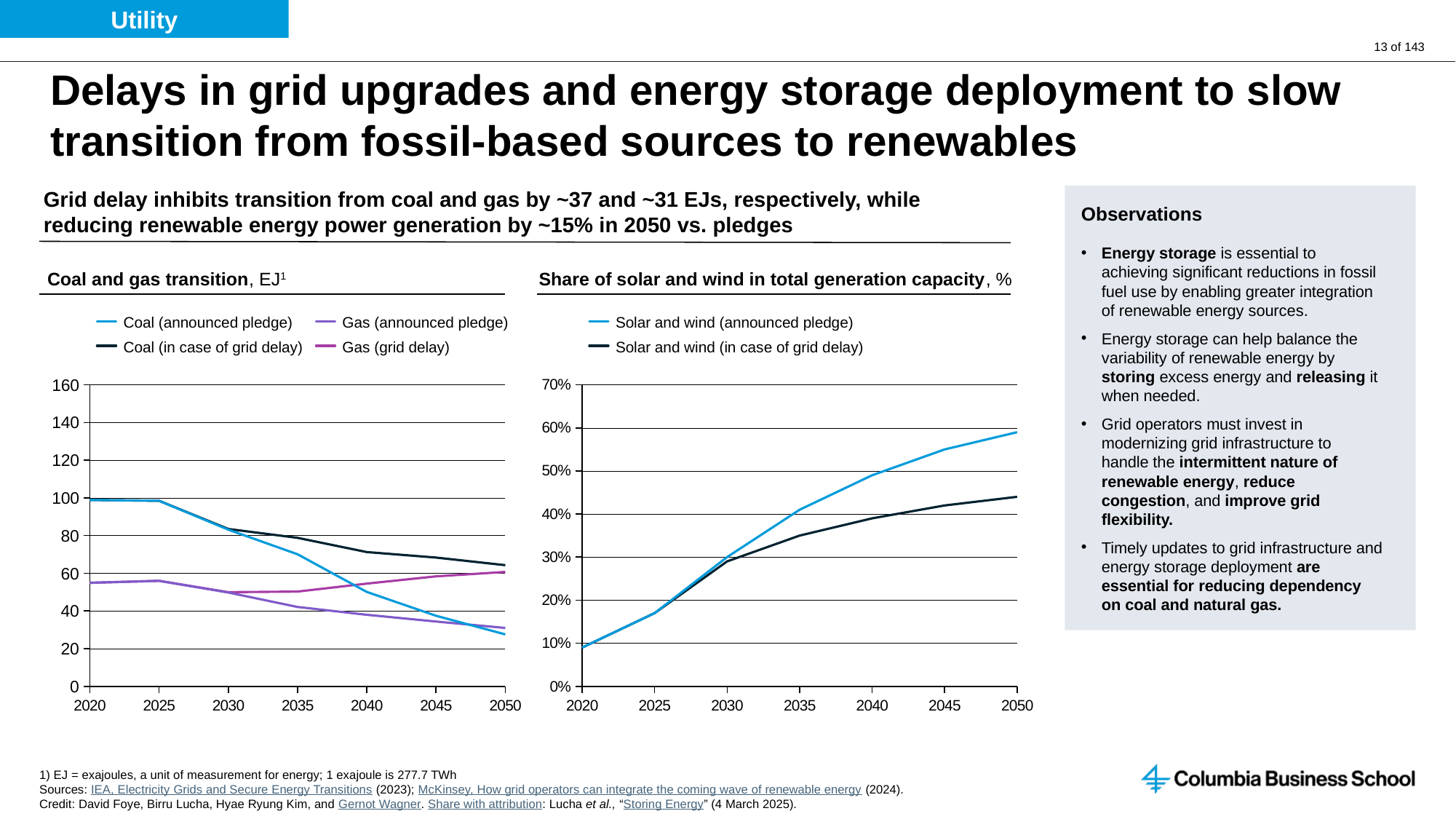
In the 'Coal and gas transition, EJ' chart, is the value for Coal (in case of grid delay) in 2050 greater or less than 60? greater In the 'Share of solar and wind in total generation capacity, %' chart, is the value for Solar and wind (announced pledge) in 2050 greater or less than 50%? greater In the 'Coal and gas transition, EJ' chart, which is higher in 2050: Coal (announced pledge) or Coal (in case of grid delay)? Coal (in case of grid delay) How many series does the legend of the 'Coal and gas transition, EJ' chart list? 4 In the 'Share of solar and wind in total generation capacity, %' chart, is the value for Solar and wind (in case of grid delay) in 2050 greater or less than 50%? less How many year labels are shown on the x axis of the 'Share of solar and wind in total generation capacity, %' chart? 7 In the 'Coal and gas transition, EJ' chart, does the Coal (announced pledge) line rise or fall from 2025 to 2050? fall In the 'Share of solar and wind in total generation capacity, %' chart, does the Solar and wind (announced pledge) line rise or fall from 2020 to 2050? rise How many series does the legend of the 'Share of solar and wind in total generation capacity, %' chart list? 2 What kind of chart is the 'Coal and gas transition, EJ' chart? line chart